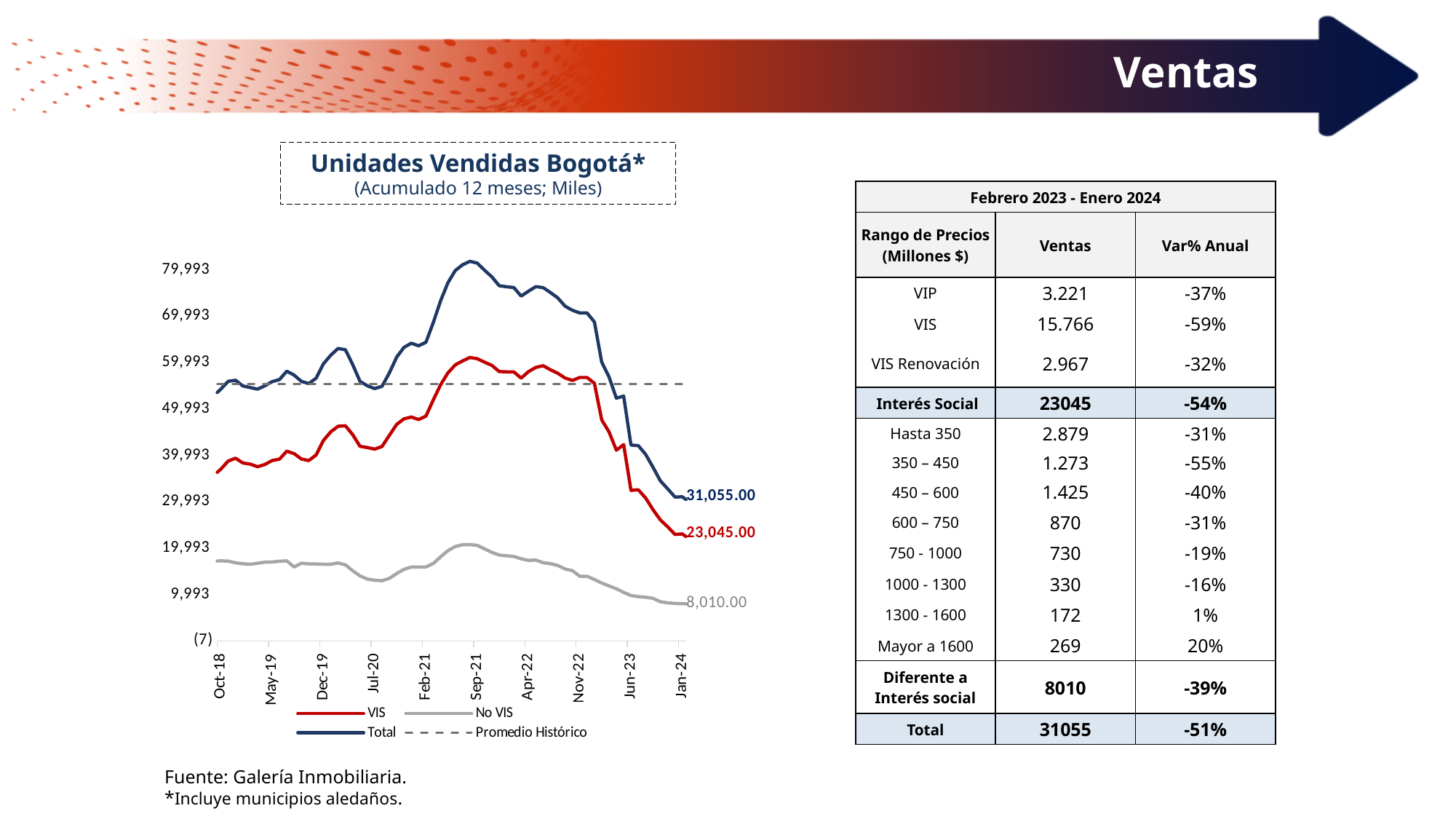
Does the Total series rise or fall between Nov-22 and Jan-24? fall At Jan-24, which is larger: the VIS value or the No VIS value? VIS What is the value of the No VIS series at Jan-24? 8,010.00 What is the difference between the VIS and No VIS values at Jan-24? 15,035.00 What is the value of the VIS series at Jan-24? 23,045.00 What is the value of the Total series at Jan-24? 31,055.00 What kind of chart is shown on the slide? line chart How many series does the chart legend list? 4 Which legend entry is shown as a dashed line? Promedio Histórico Which series has the highest value at Jan-24? Promedio Histórico What is the difference between the Total and VIS values at Jan-24? 8,010.00 Is the value of the Total series at Sep-21 greater or less than 69,993? greater